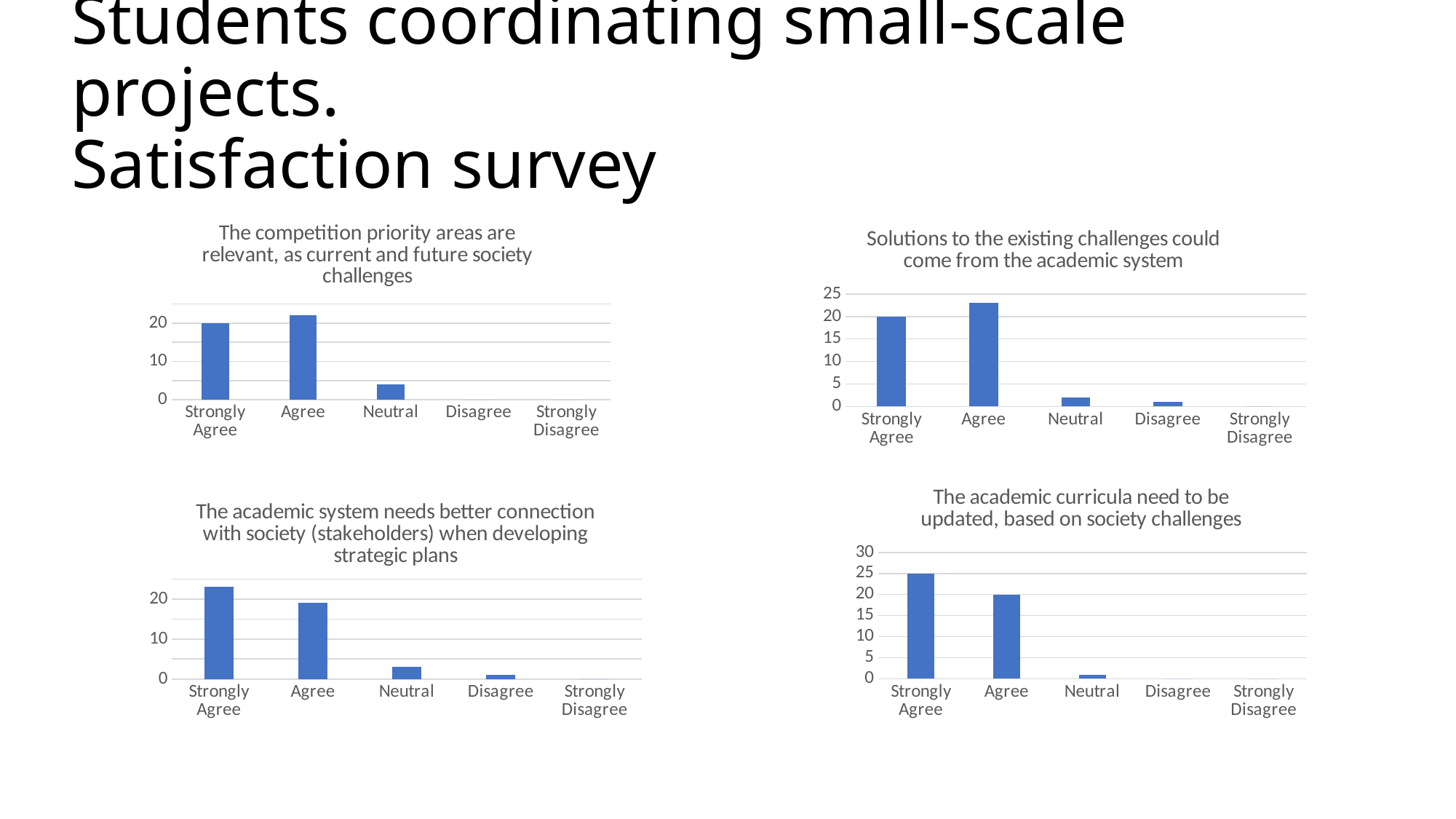
In the chart titled "Solutions to the existing challenges could come from the academic system", what is the value for Strongly Agree? 20 How many categories are shown on the x axis of the chart titled "The academic curricula need to be updated, based on society challenges"? 5 In the chart titled "The academic curricula need to be updated, based on society challenges", what is the value for Agree? 20 In the chart titled "The academic system needs better connection with society (stakeholders) when developing strategic plans", which category has the highest value? Strongly Agree In the chart titled "The academic curricula need to be updated, based on society challenges", what is the value for Strongly Agree? 25 In the chart titled "The competition priority areas are relevant, as current and future society challenges", which is larger, the value for Agree or the value for Neutral? Agree In the chart titled "The academic curricula need to be updated, based on society challenges", what is the difference between the Strongly Agree and Agree values? 5 What kind of chart is the chart titled "Solutions to the existing challenges could come from the academic system"? bar chart In the chart titled "The academic system needs better connection with society (stakeholders) when developing strategic plans", is the value for Agree greater or less than 20? less In the chart titled "The competition priority areas are relevant, as current and future society challenges", is the value for Agree greater or less than 20? greater In the chart titled "Solutions to the existing challenges could come from the academic system", which category has the highest value? Agree In the chart titled "Solutions to the existing challenges could come from the academic system", is the value for Neutral greater or less than 5? less